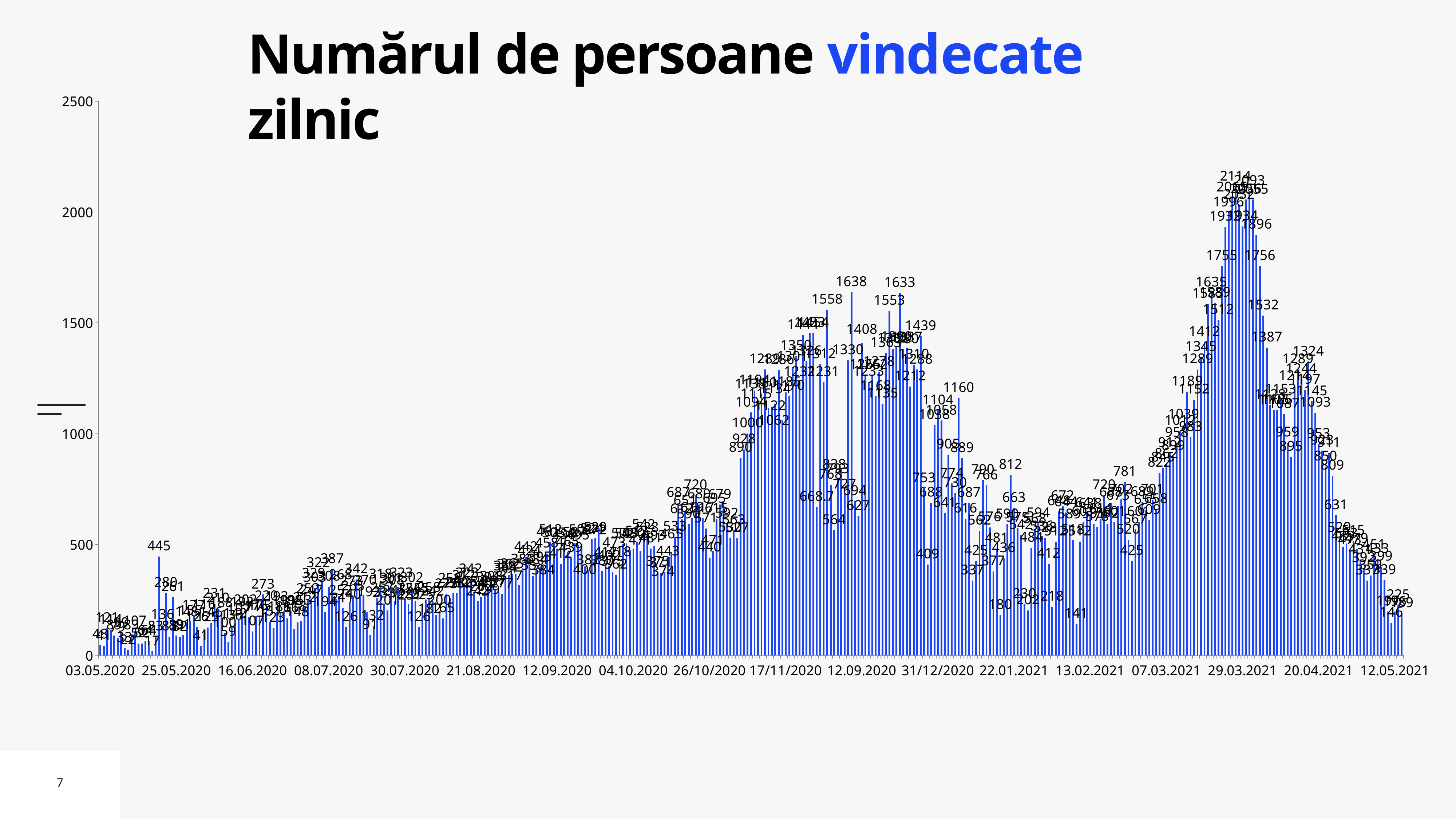
What is the title of the chart? Numărul de persoane vindecate zilnic What is the highest value labeled on the chart? 2114 What is the difference between the overall peak value (2114) and the November 2020 peak value (1638)? 476 Is the first bar at 03.05.2020 greater or less than 500? less Is the highest bar near 29.03.2021 greater or less than 2000? greater Which is larger: the peak around 29.03.2021 or the peak around 17/11/2020? the peak around 29.03.2021 What kind of chart is shown on the slide? bar chart Do the values rise or fall between 29.03.2021 and 12.05.2021? fall What is the maximum value shown on the vertical axis? 2500 How many date labels are shown on the horizontal axis? 18 What is the highest value labeled in the peak around 17/11/2020? 1638 Do the values rise or fall between 07.03.2021 and 29.03.2021? rise